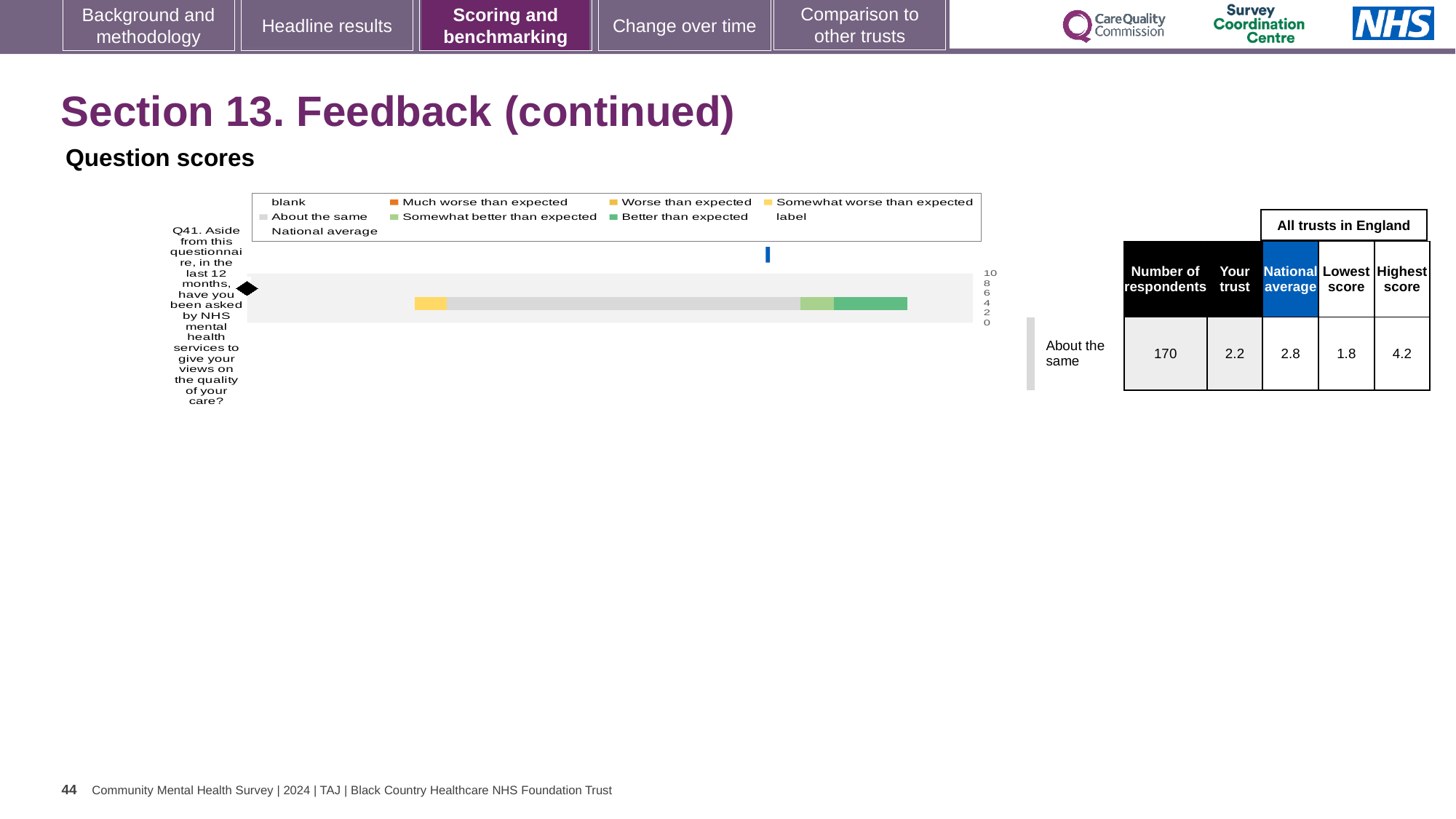
For Q41, what is the difference between the national average and the 'Your trust' score? 0.6 In the table next to the chart, what is the highest score among all trusts in England for Q41? 4.2 For Q41, which is larger: the 'Your trust' score or the national average? National average How many survey questions are plotted in the chart? 1 In the table next to the chart, what is the 'Your trust' score for Q41? 2.2 Which question number is plotted in the chart? Q41 In the table next to the chart, what is the number of respondents for Q41? 170 For Q41, what is the difference between the highest score and the lowest score among all trusts in England? 2.4 In the table next to the chart, what is the national average score for Q41? 2.8 What kind of chart is shown under 'Question scores'? bar chart What benchmark category label is shown beside the table for Q41? About the same In the table next to the chart, what is the lowest score among all trusts in England for Q41? 1.8